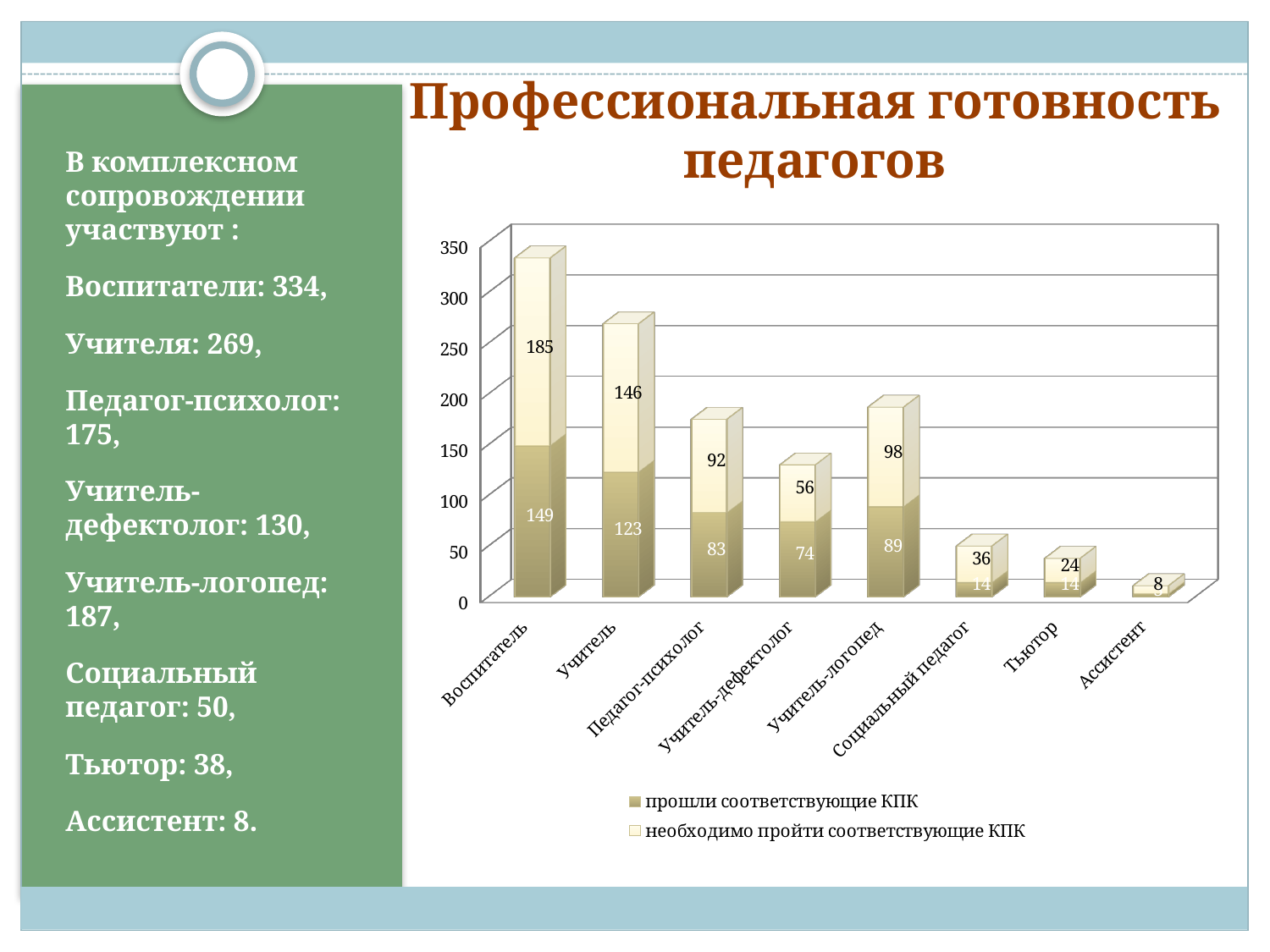
What is the difference between the 'необходимо пройти соответствующие КПК' values for Воспитатель and Учитель? 39 How many series does the legend list? 2 Which category has the lowest value for 'необходимо пройти соответствующие КПК'? Ассистент What is the total of the stacked bar for Педагог-психолог? 175 What type of chart is shown on the slide? bar chart What is the value of 'прошли соответствующие КПК' for Учитель-дефектолог? 74 Which is larger for Учитель-логопед: 'прошли соответствующие КПК' or 'необходимо пройти соответствующие КПК'? необходимо пройти соответствующие КПК What is the value of 'необходимо пройти соответствующие КПК' for Учитель? 146 Which category has the highest value for 'необходимо пройти соответствующие КПК'? Воспитатель Is the total stacked bar for Учитель greater or less than 250? greater What is the value of 'прошли соответствующие КПК' for Воспитатель? 149 How many categories are shown on the x axis? 8